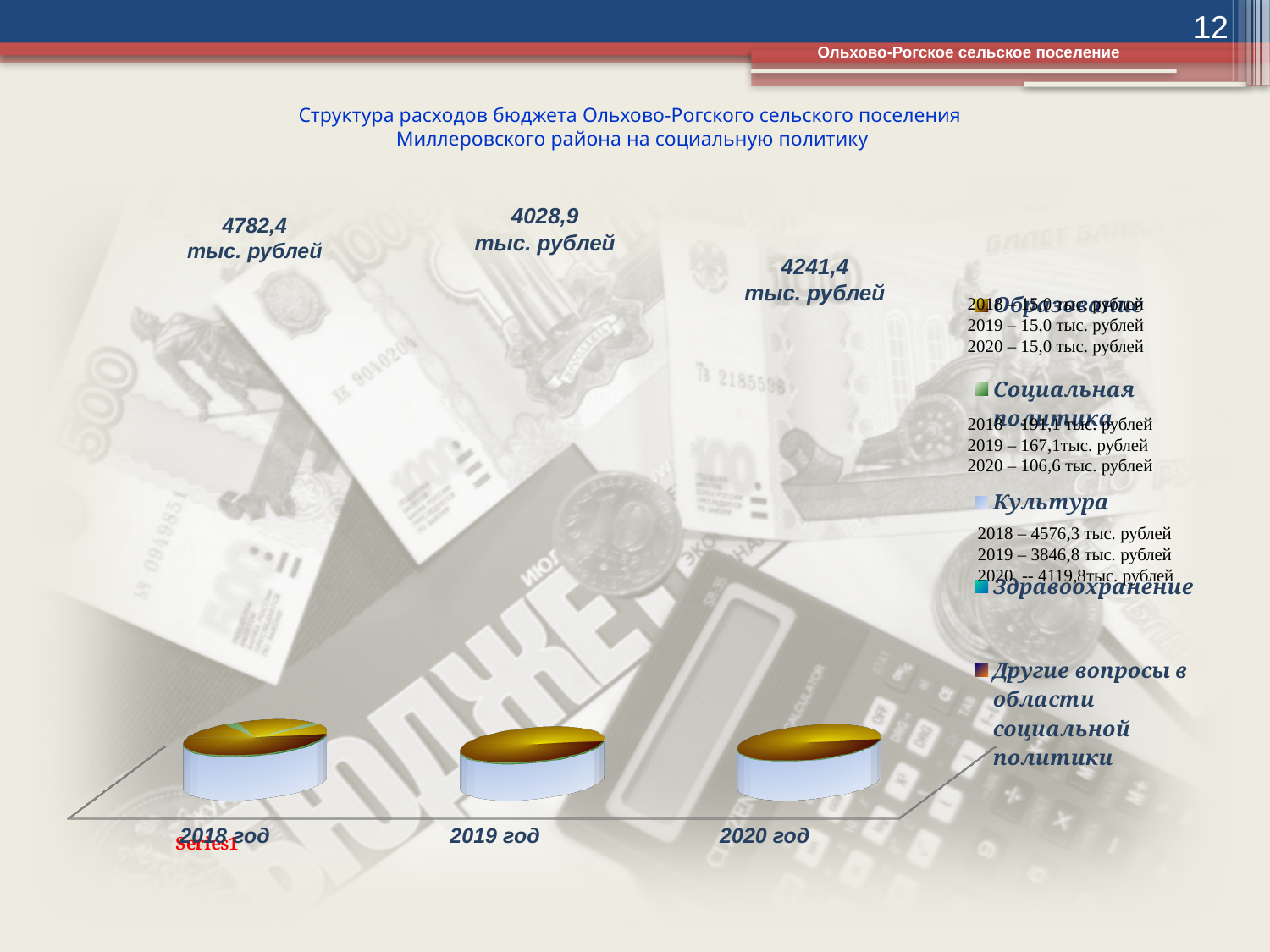
How many entries does the legend list? 5 Which year has the highest total printed above its pie chart? 2018 год What kind of chart is used on the slide? pie chart Which year has the lowest total printed above its pie chart? 2019 год What total value is printed above the pie chart for 2018 год? 4782,4 тыс. рублей According to the text on the slide, what was spent on Социальная политика in 2020? 106,6 тыс. рублей How many pie charts are shown on the slide? 3 What is the difference between the totals printed for 2018 год and 2019 год? 753,5 тыс. рублей Which year had the larger value for Социальная политика, 2018 or 2019? 2018 According to the text on the slide, what was spent on Культура in 2018? 4576,3 тыс. рублей What total value is printed above the pie chart for 2019 год? 4028,9 тыс. рублей What total value is printed above the pie chart for 2020 год? 4241,4 тыс. рублей